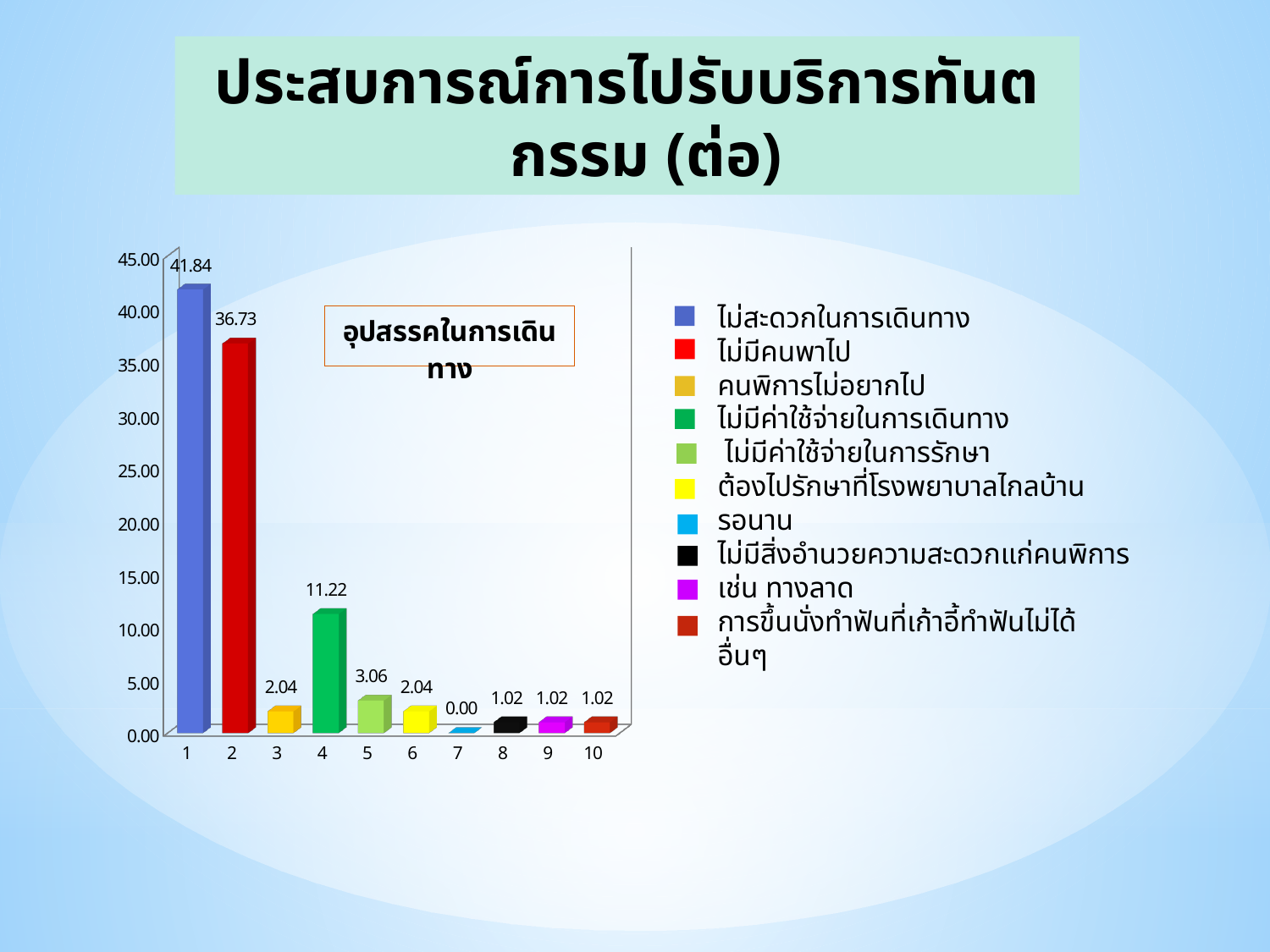
Is the value for category 1 greater or less than 40.00? greater What is the difference between the values for category 4 and category 5? 8.16 Which category has the lowest value? 7 What is the value for category 1? 41.84 What is the value for category 7? 0.00 How many categories are plotted on the x axis? 10 Which category has the highest value? 1 What kind of chart is shown on the slide? bar chart What is the value for category 2? 36.73 Which is larger, the value for category 3 or category 5? category 5 What is the value for category 4? 11.22 What is the difference between the values for category 1 and category 2? 5.11